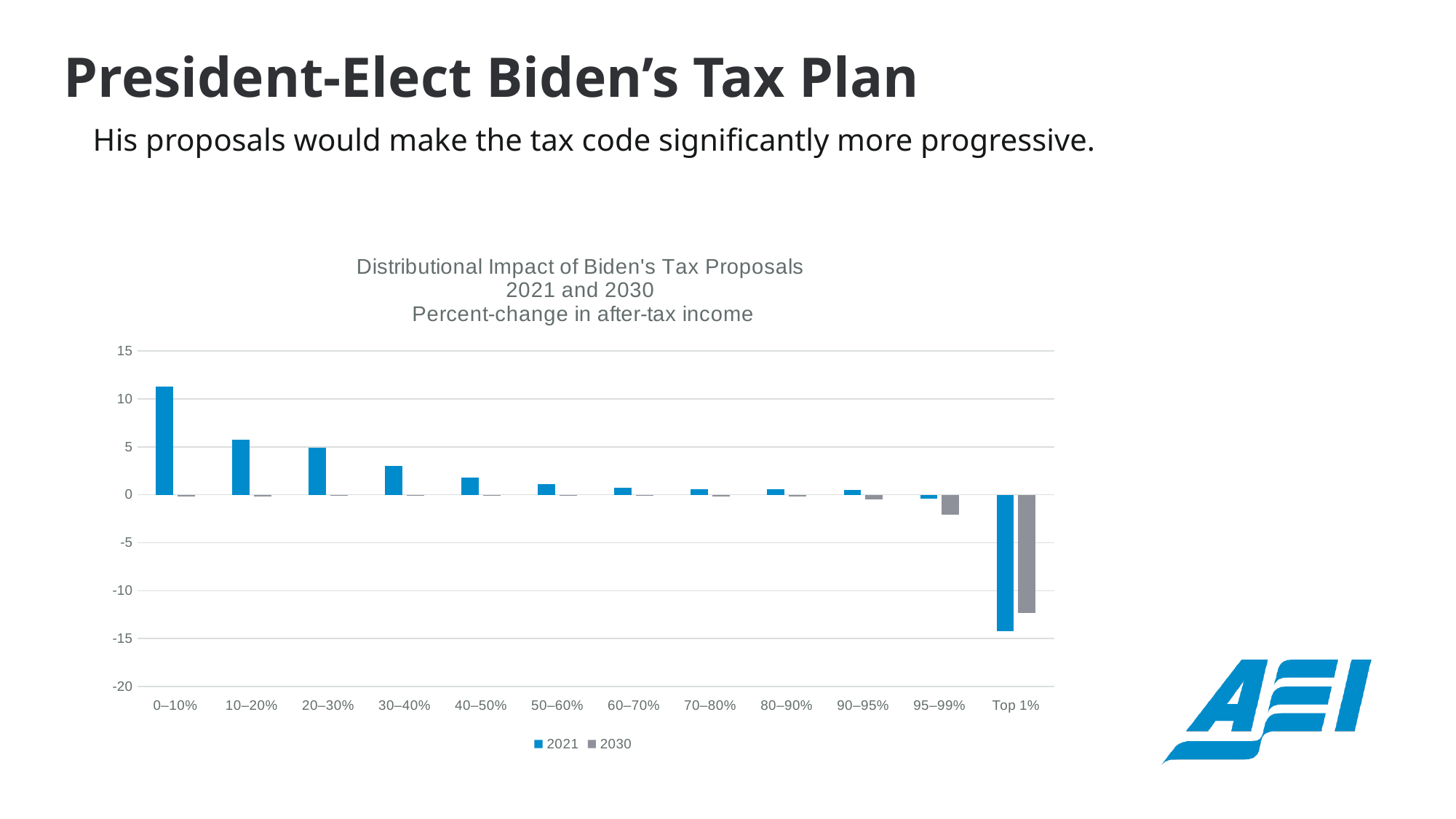
Is the 2021 value for 10–20% greater or less than 5? greater Which income group has the lowest 2030 value? Top 1% What kind of chart is shown on the slide? bar chart What are the two series listed in the legend? 2021 and 2030 Is the 2021 value for Top 1% greater or less than -10? less Which income group has the highest 2021 value? 0–10% How many income groups (categories) are shown on the x axis? 12 Which is larger, the 2021 value for 0–10% or the 2021 value for 10–20%? 0–10% Which income group has the lowest 2021 value? Top 1% Do the 2021 values generally rise or fall moving from 0–10% to Top 1% along the x axis? fall How many series does the legend list? 2 Is the 2021 value for 0–10% greater or less than 10? greater